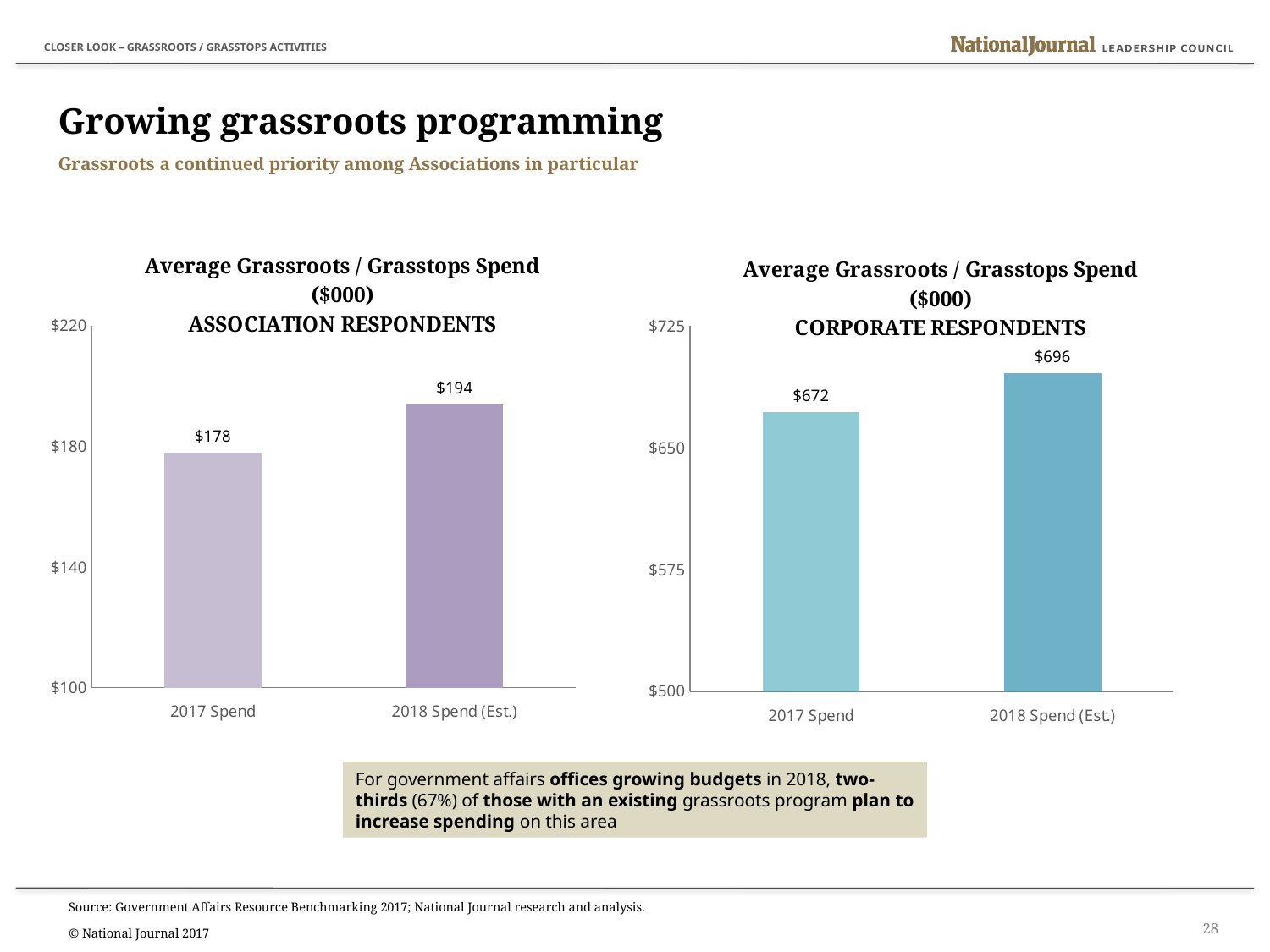
In the Corporate Respondents chart, do the values rise or fall from 2017 Spend to 2018 Spend (Est.)? rise How many categories are shown in the Association Respondents chart? 2 In the Corporate Respondents chart, which category has the highest value? 2018 Spend (Est.) In the Association Respondents chart, which category has the lowest value? 2017 Spend In the Corporate Respondents chart, what is the value for 2017 Spend? $672 In the Corporate Respondents chart, what is the difference between 2018 Spend (Est.) and 2017 Spend? $24 In the Association Respondents chart, what is the value for 2017 Spend? $178 What kind of chart is the Corporate Respondents chart? bar chart In the Association Respondents chart, is the value for 2017 Spend greater or less than $180? less In the Association Respondents chart, what is the difference between 2018 Spend (Est.) and 2017 Spend? $16 In the Association Respondents chart, what is the value for 2018 Spend (Est.)? $194 In the Corporate Respondents chart, what is the value for 2018 Spend (Est.)? $696